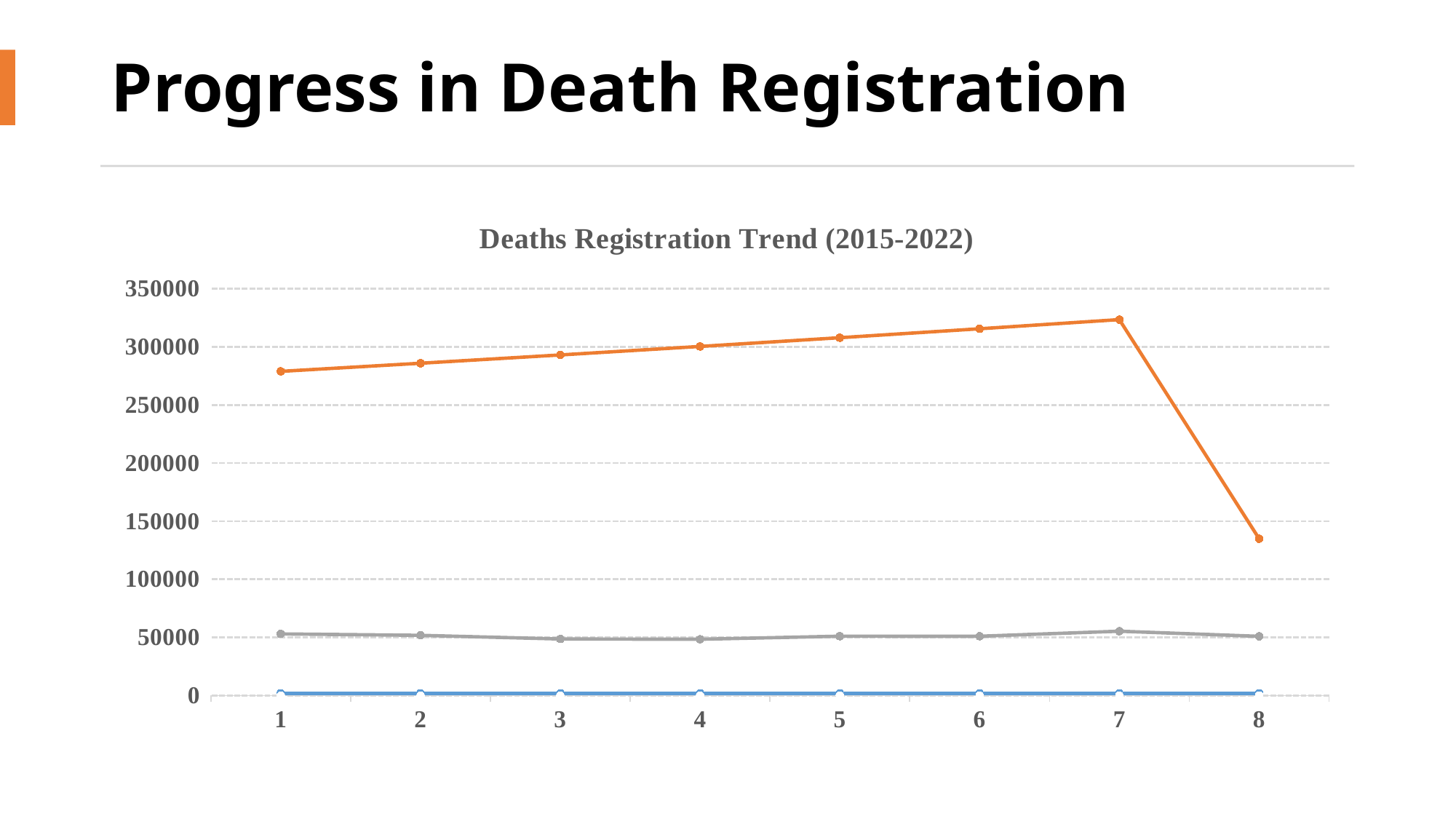
Is the value of the gray line at point 4 greater or less than 100000? less Is the value of the orange line at point 7 greater or less than 300000? greater What is the title of the chart? Deaths Registration Trend (2015-2022) At which x-axis point does the orange line reach its lowest value? 8 What kind of chart is shown on the slide? line chart How many points are plotted along the x axis for each line? 8 Does the orange line rise or fall from point 1 to point 7? rise At which x-axis point does the orange line reach its highest value? 7 How many lines are plotted on the chart? 3 Is the value of the orange line at point 1 greater or less than 250000? greater At point 8, which line has the larger value, the orange line or the gray line? orange line